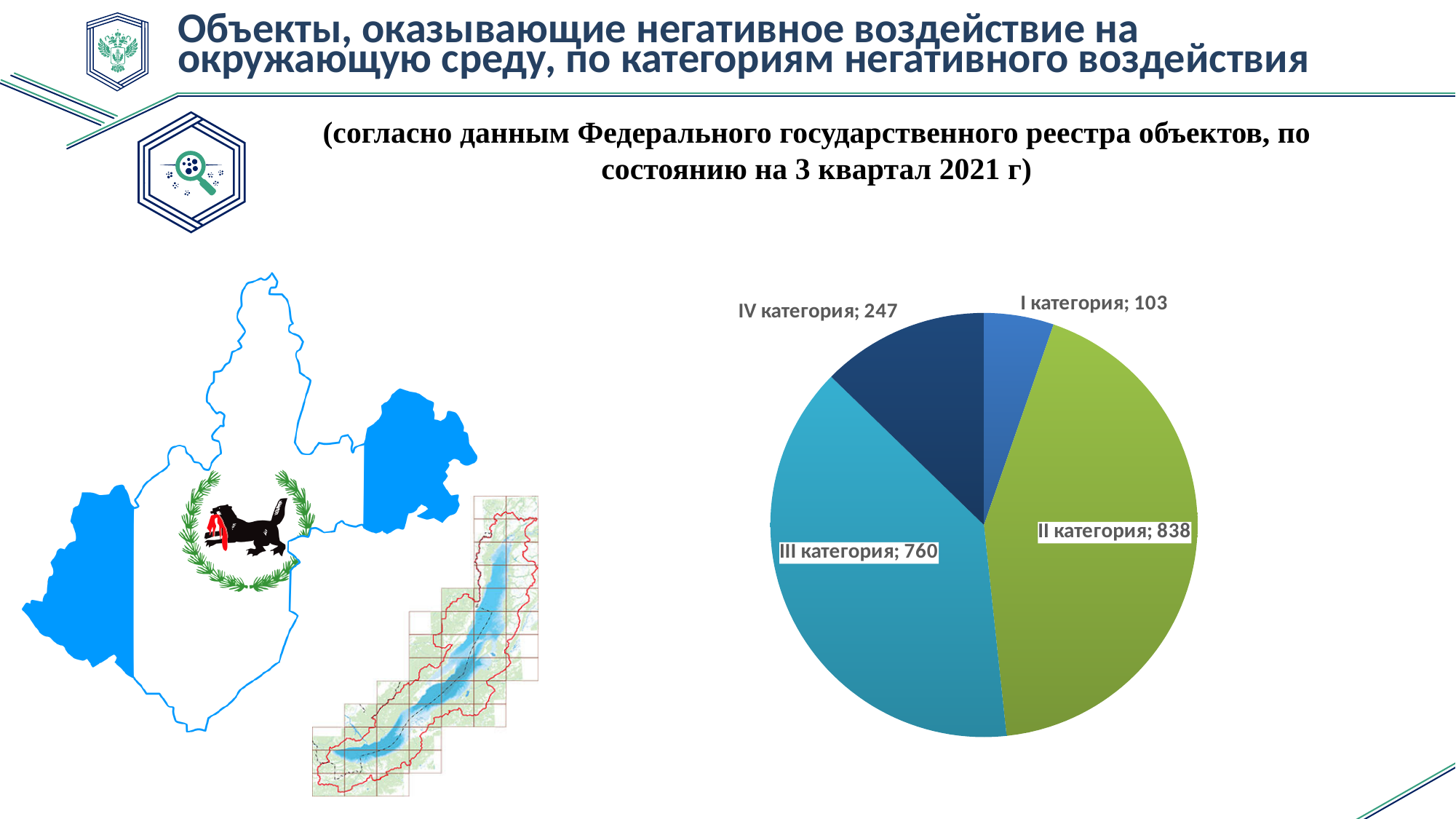
Which category has the largest slice in the pie chart? II категория What is the value for II категория in the pie chart? 838 What is the total of all values in the pie chart? 1948 Which category has the smallest slice in the pie chart? I категория What is the difference between the values for IV категория and I категория? 144 What is the value for I категория in the pie chart? 103 How many categories are shown in the pie chart? 4 What share of the pie does II категория represent? 43.0% Which is larger, the value for III категория or the value for IV категория? III категория What is the difference between the values for II категория and III категория? 78 What is the value for IV категория in the pie chart? 247 What kind of chart is shown on the slide? pie chart